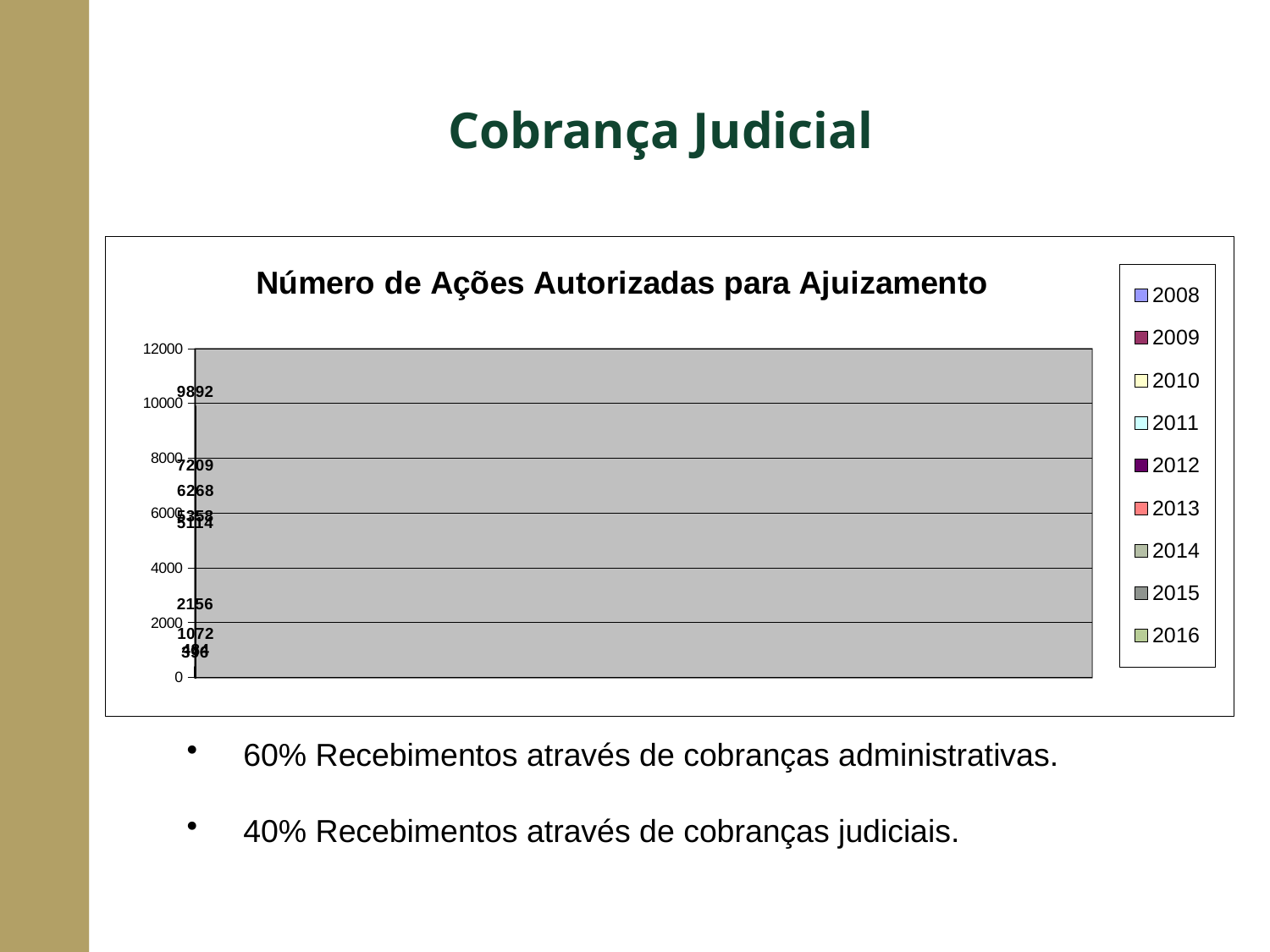
What is the maximum value shown on the vertical axis of the chart? 12000 What is the highest data label value shown on the chart? 9892 What is the difference between the highest labelled value (9892) and the labelled value 7209? 2683 Which is larger, the labelled value 6268 or the labelled value 5114? 6268 Which year is the last entry in the chart legend? 2016 How many series does the chart legend list? 9 What kind of chart is shown on the slide? bar chart Is the highest labelled value on the chart greater or less than 8000? greater Which year is the first entry in the chart legend? 2008 What is the title of the chart? Número de Ações Autorizadas para Ajuizamento